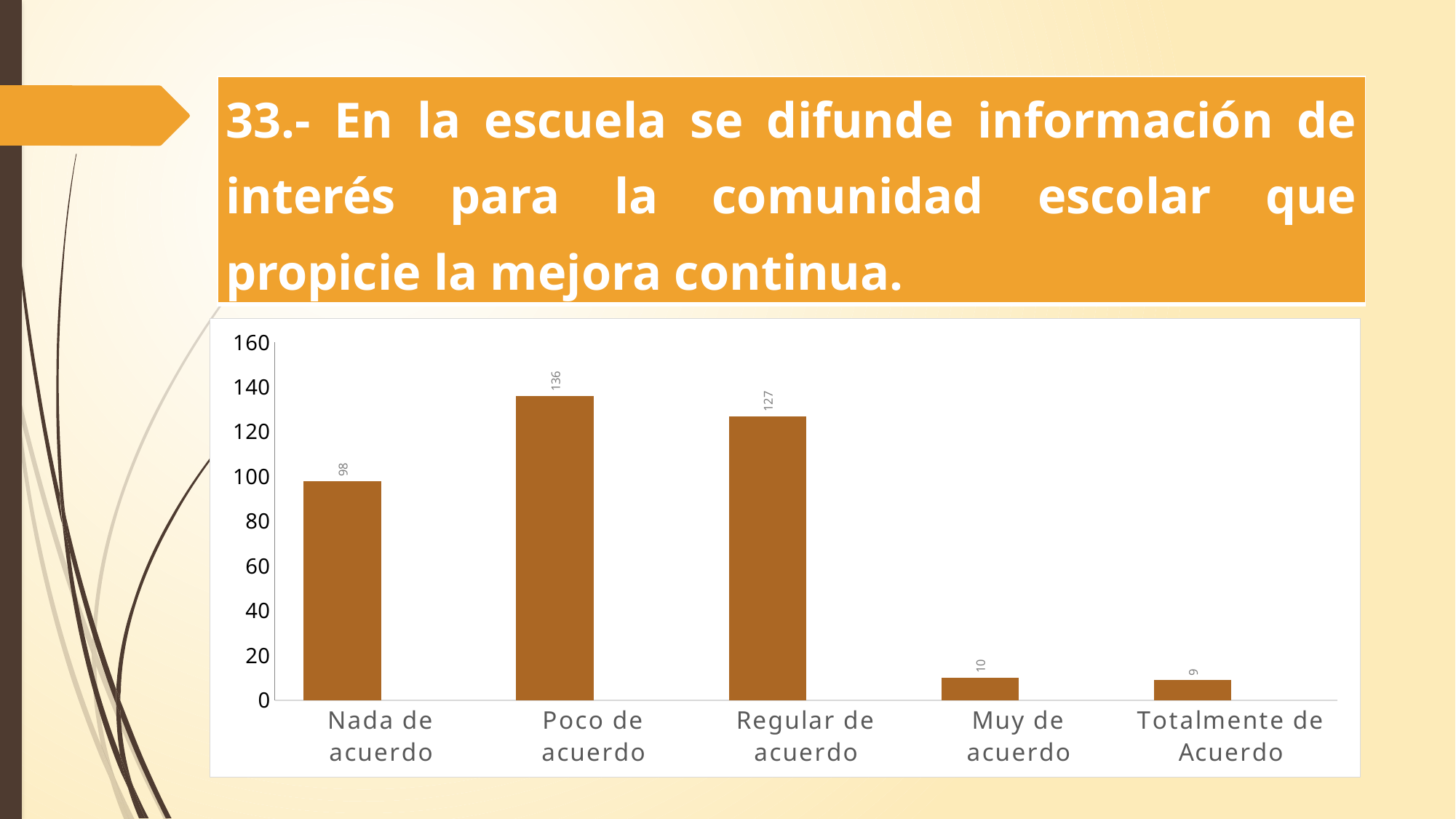
What kind of chart is shown on the slide? bar chart What is the highest value shown on the vertical axis? 160 Is the value for "Muy de acuerdo" greater or less than 20? less What is the value for "Poco de acuerdo"? 136 What is the difference between the values for "Regular de acuerdo" and "Nada de acuerdo"? 29 What is the value for "Nada de acuerdo"? 98 Which category has the lowest value? Totalmente de Acuerdo Which category has the highest value? Poco de acuerdo How many categories are shown on the x axis? 5 What is the difference between the values for "Poco de acuerdo" and "Regular de acuerdo"? 9 Which is larger, the value for "Nada de acuerdo" or the value for "Regular de acuerdo"? Regular de acuerdo What is the value for "Totalmente de Acuerdo"? 9